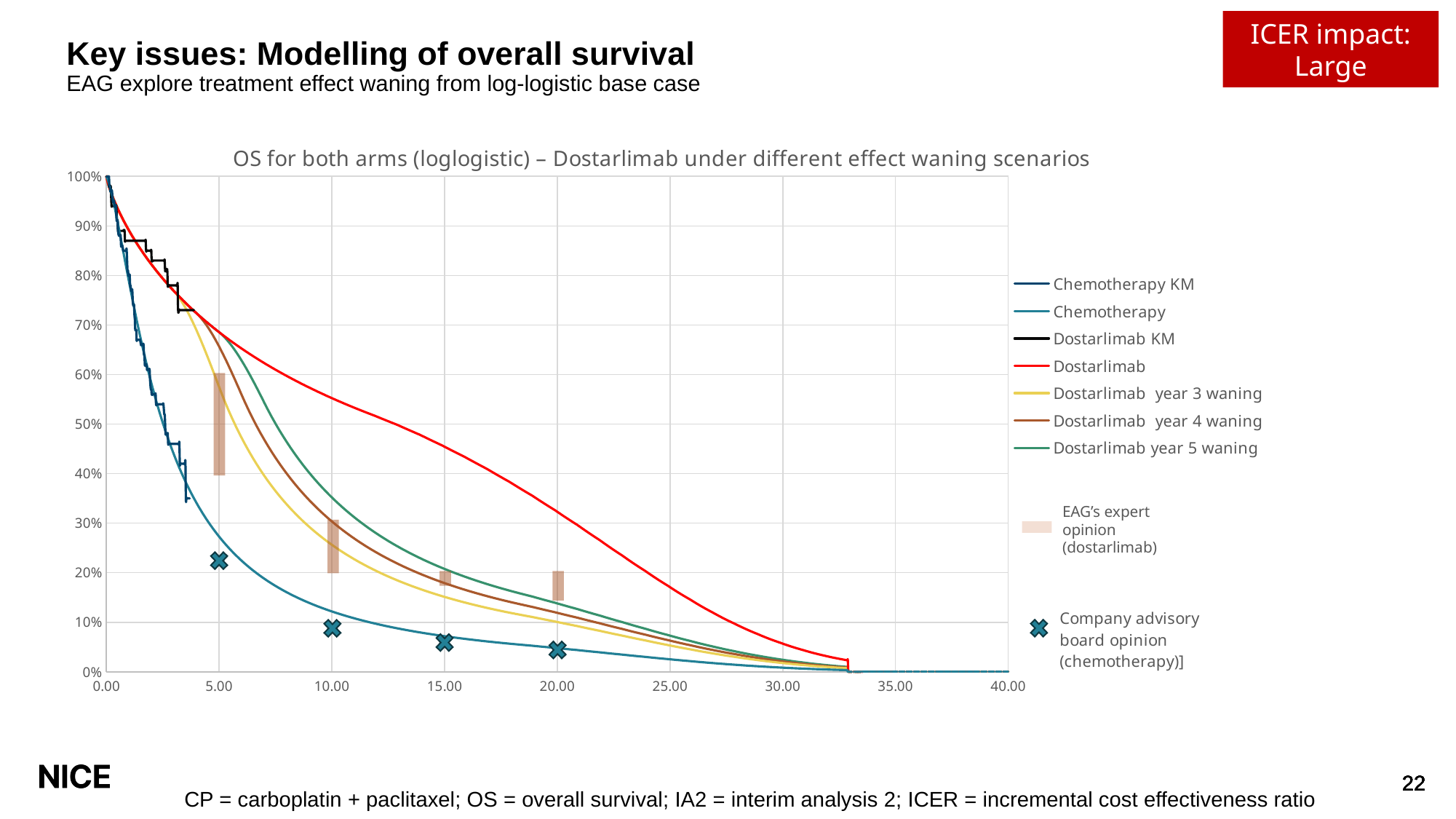
At x = 10.00, which is higher: the Dostarlimab curve or the Dostarlimab year 3 waning curve? Dostarlimab Is the value of the Dostarlimab year 5 waning curve at x = 10.00 greater or less than 30%? greater What is the title of the chart? OS for both arms (loglogistic) – Dostarlimab under different effect waning scenarios Is the value of the Dostarlimab year 3 waning curve at x = 10.00 greater or less than 30%? less What kind of chart is shown on the slide? line chart How many Dostarlimab effect waning scenarios are listed in the chart legend? 3 Is the value of the Dostarlimab curve at x = 10.00 greater or less than 50%? greater Which legend entry is drawn in red? Dostarlimab Do the survival curves rise or fall as the x axis increases? fall What is the highest value shown on the y axis? 100% Among the three Dostarlimab waning scenarios, which curve is lowest at x = 10.00? Dostarlimab year 3 waning